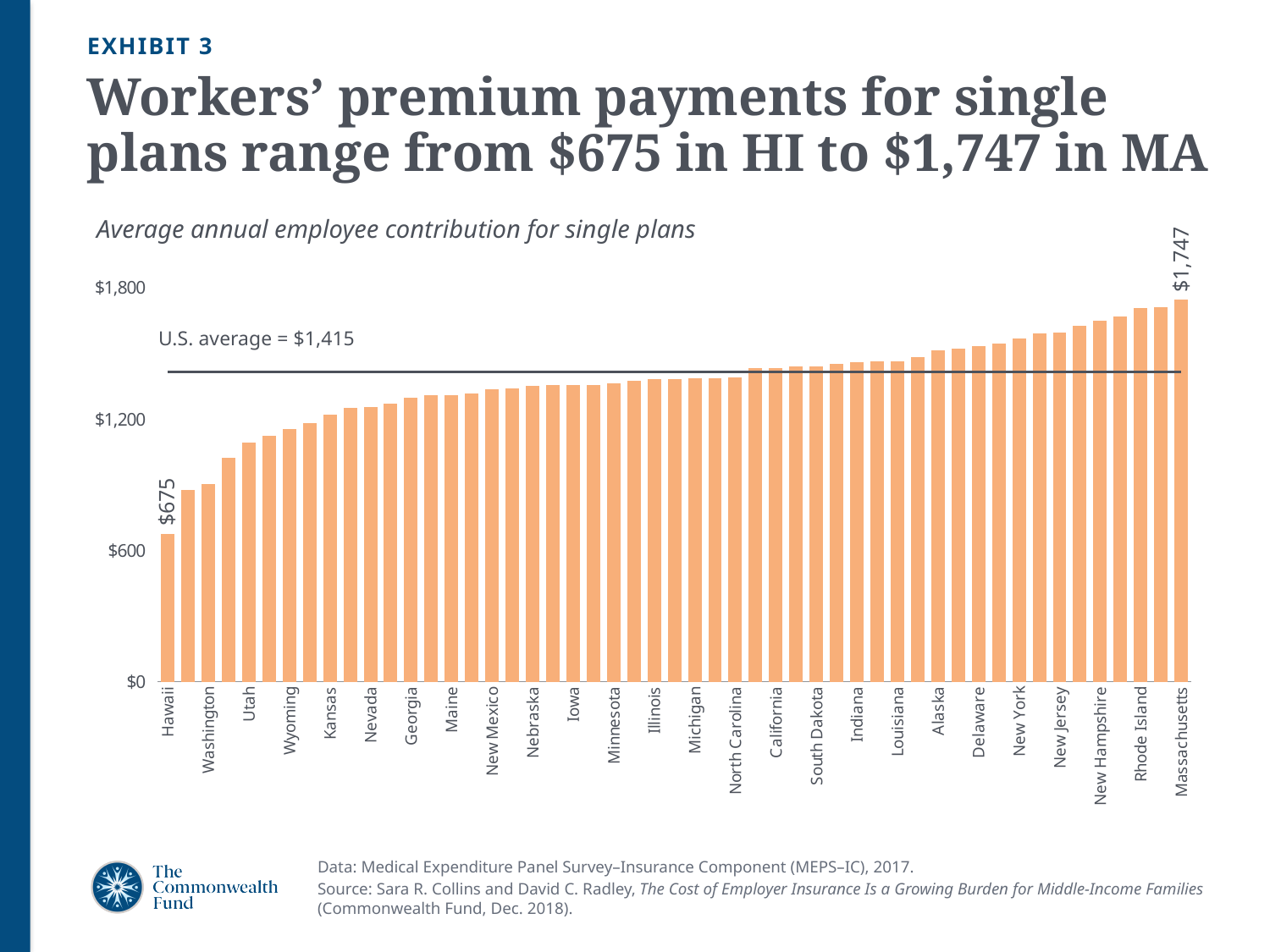
What U.S. average value is marked by the horizontal line on the chart? $1,415 Is the value for Washington greater or less than $1,200? less What is the average annual employee contribution for single plans in Massachusetts? $1,747 How much higher is the Massachusetts value than the U.S. average shown on the chart? $332 Which state has the lowest average annual employee contribution for single plans? Hawaii Is the value for Georgia greater or less than $1,200? greater What is the average annual employee contribution for single plans in Hawaii? $675 Which is larger, the employee contribution in Washington or in New York? New York What is the difference between the employee contribution in Massachusetts and in Hawaii? $1,072 What kind of chart is shown on the slide? Bar chart Do the values rise or fall moving from left to right along the x axis? Rise Which state has the highest average annual employee contribution for single plans? Massachusetts